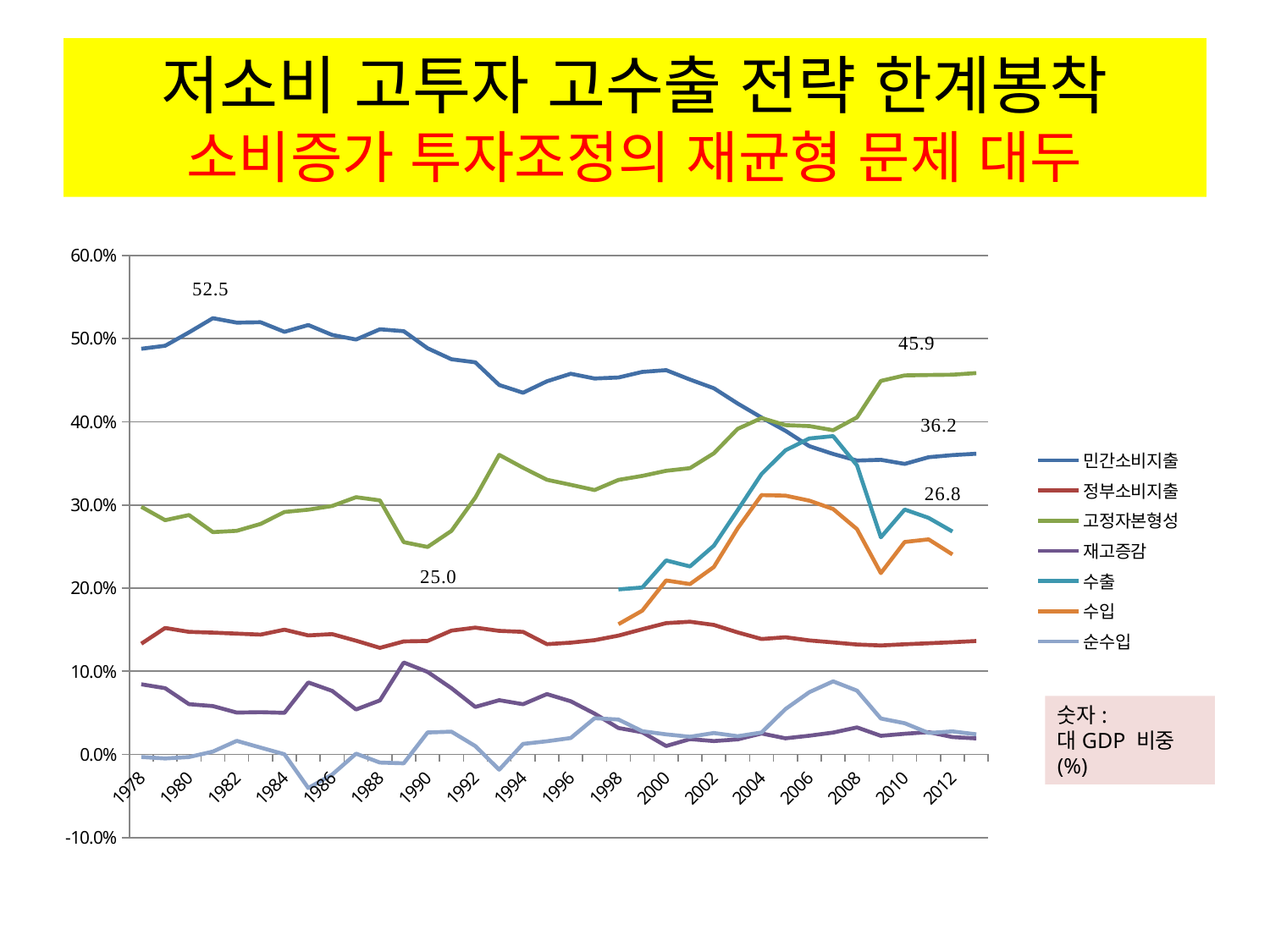
Is the value for 정부소비지출 in 2012 greater or less than 20.0%? less What is the labeled value of the 수출 series at the right end of the chart? 26.8 Does the 민간소비지출 series rise or fall overall from 1978 to the end of the chart? fall What is the labeled value of the 고정자본형성 series at the right end of the chart? 45.9 What is the labeled value of the 민간소비지출 series at the right end of the chart? 36.2 What is the difference between the labeled peak of 민간소비지출 (52.5) and its final labeled value (36.2)? 16.3 What is the labeled low value of the 고정자본형성 series around 1990? 25.0 How many series does the legend list? 7 What is the difference between the final labeled values of 고정자본형성 (45.9) and 민간소비지출 (36.2)? 9.7 What is the labeled peak value of the 민간소비지출 series in the early 1980s? 52.5 What kind of chart is shown on the slide? line chart At the right end of the chart, which is larger: 고정자본형성 or 민간소비지출? 고정자본형성